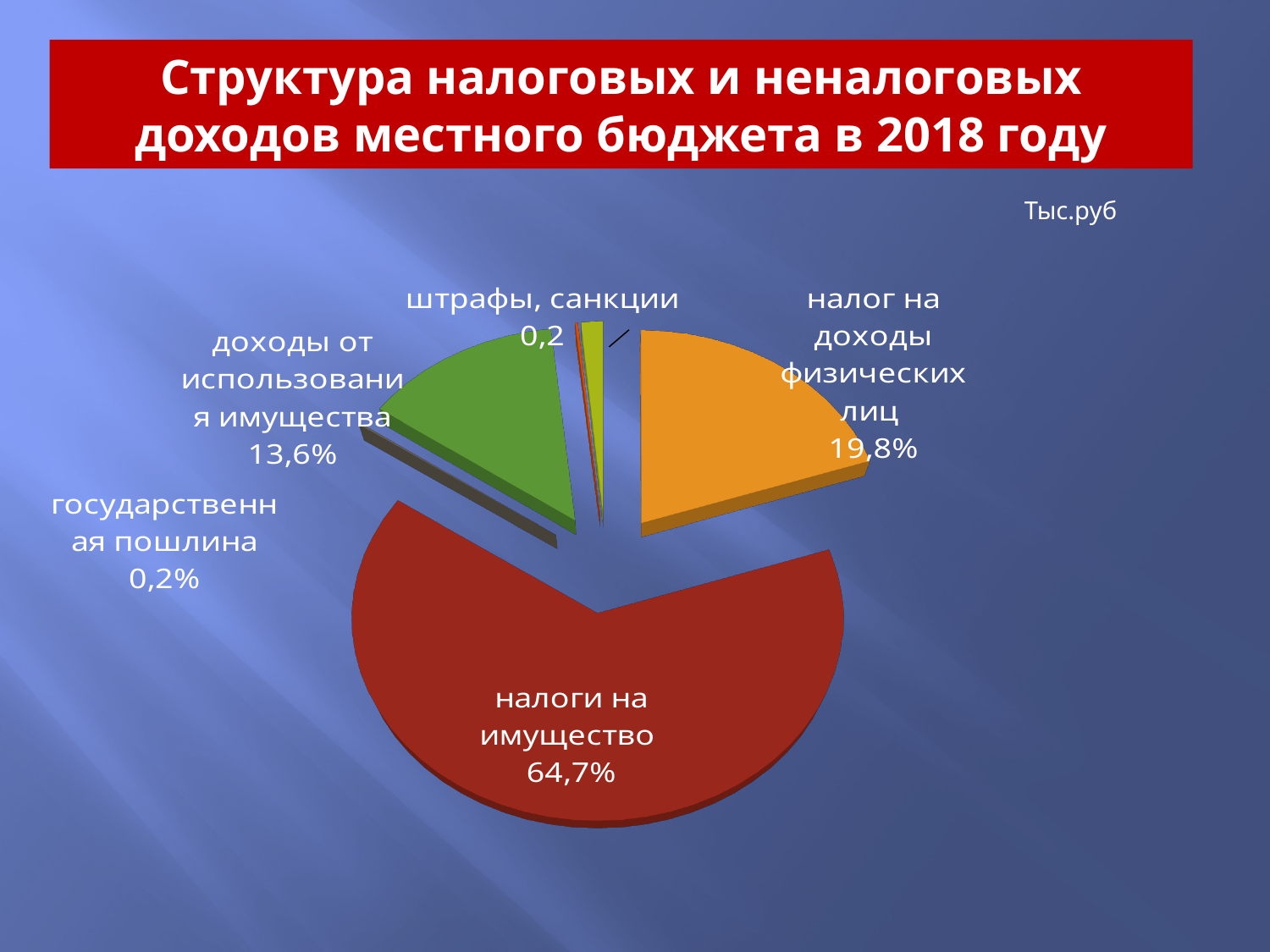
What value is labelled for штрафы, санкции? 0,2 What is the difference in percentage points between налог на доходы физических лиц and доходы от использования имущества? 6,2 What share of the pie does налоги на имущество have? 64,7% Which category has the largest slice of the pie? налоги на имущество What colour is the slice for налоги на имущество? red What type of chart is shown on the slide? pie chart What value is shown for государственная пошлина? 0,2% What share is shown for налог на доходы физических лиц? 19,8% What share is shown for доходы от использования имущества? 13,6% What is the difference in percentage points between налоги на имущество and налог на доходы физических лиц? 44,9 What is the title of the chart on the slide? Структура налоговых и неналоговых доходов местного бюджета в 2018 году Which is larger: налог на доходы физических лиц or доходы от использования имущества? налог на доходы физических лиц